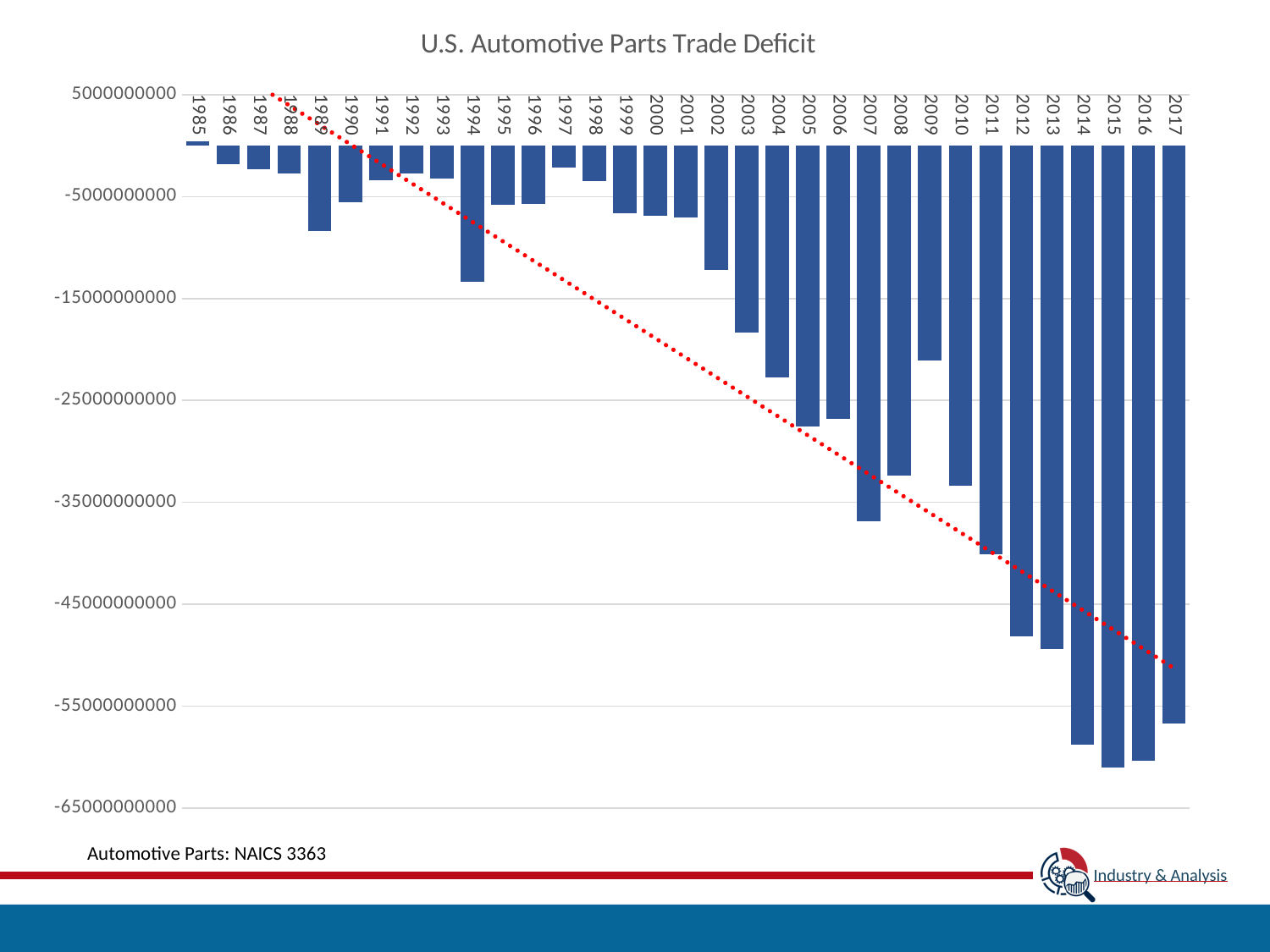
Is the value for 2003 greater or less than -25000000000? greater Do the values generally rise or fall from 1985 to 2017? fall Is the value for 2007 greater or less than -35000000000? less What kind of chart is shown on the slide? bar chart Which year has the larger value, 1989 or 1990? 1990 What is the title of the chart? U.S. Automotive Parts Trade Deficit Is the value for 2017 greater or less than -55000000000? less How many years are plotted on the x axis of the chart? 33 Which year has the highest (least negative) value in the chart? 1985 What colour is the dotted trend line on the chart? red Which year has the larger value, 2007 or 2008? 2008